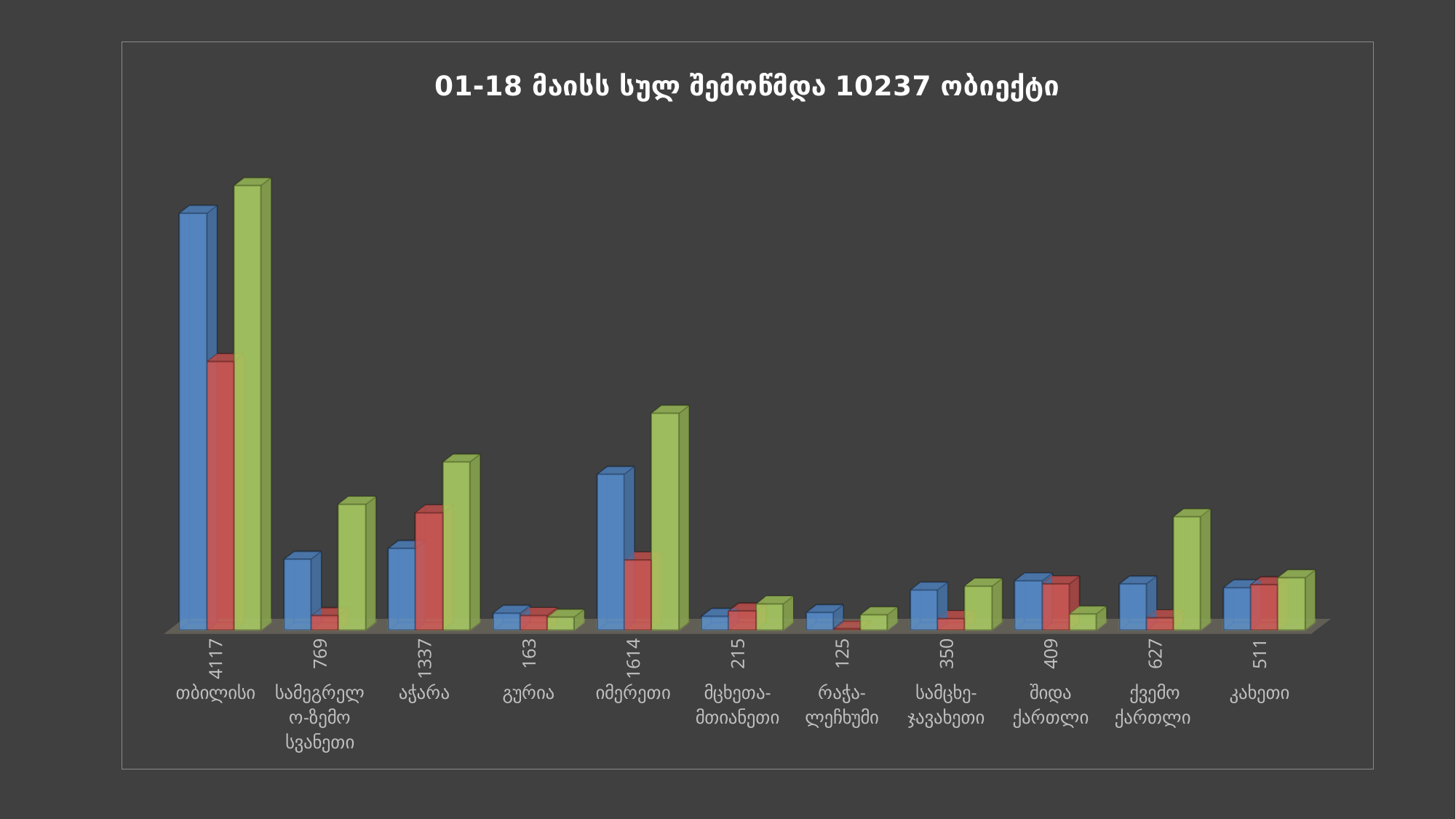
What is the difference between the numbers printed for იმერეთი and აჭარა? 277 What number is printed below თბილისი? 4117 What number is printed below იმერეთი? 1614 What kind of chart is shown on the slide? bar chart What total number of objects is stated in the chart title? 10237 What number is printed below ქვემო ქართლი? 627 Which category has the highest printed number? თბილისი How many bars are shown for each category? 3 Which has the larger printed number, შიდა ქართლი or სამცხე-ჯავახეთი? შიდა ქართლი What number is printed below რაჭა-ლეჩხუმი? 125 Which category has the lowest printed number? რაჭა-ლეჩხუმი How many categories are shown on the x axis? 11